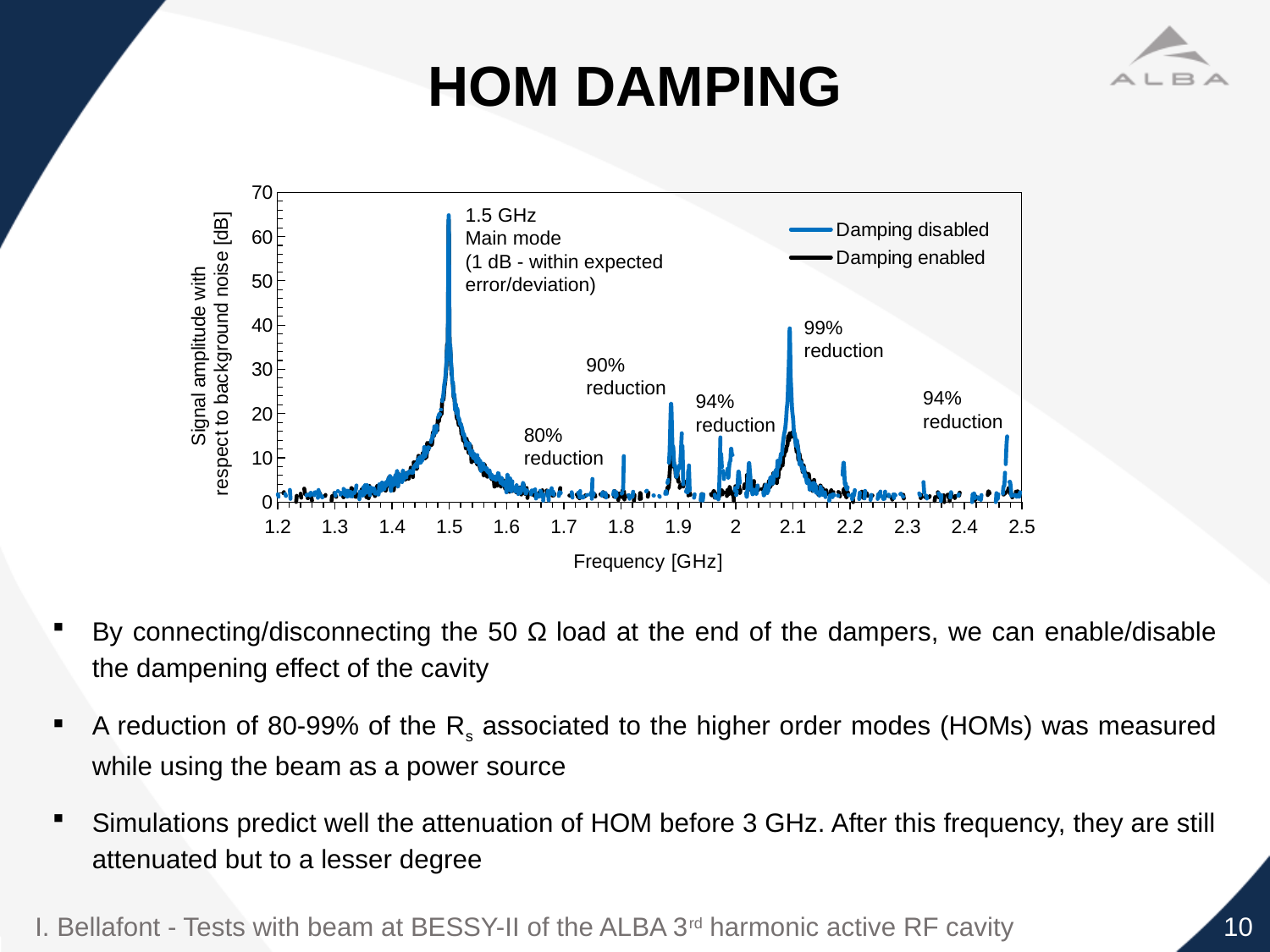
What reduction percentage is annotated for the peak near 1.75 GHz? 80% Is the peak value of the Damping disabled series at 1.5 GHz greater or less than 60 dB? greater At which frequency does the Damping disabled series reach its highest peak? 1.5 GHz Is the peak value of the Damping disabled series near 2.1 GHz greater or less than 30 dB? greater What is the label of the x axis? Frequency [GHz] How many series does the legend list? 2 How many reduction percentages are annotated on the chart? 5 What are the two series named in the legend? Damping disabled, Damping enabled At what frequency is the main mode annotated on the chart? 1.5 GHz What kind of chart is shown on the slide? line chart What reduction percentage is annotated for the peak near 1.9 GHz? 90% What reduction percentage is annotated for the peak near 2.1 GHz? 99%